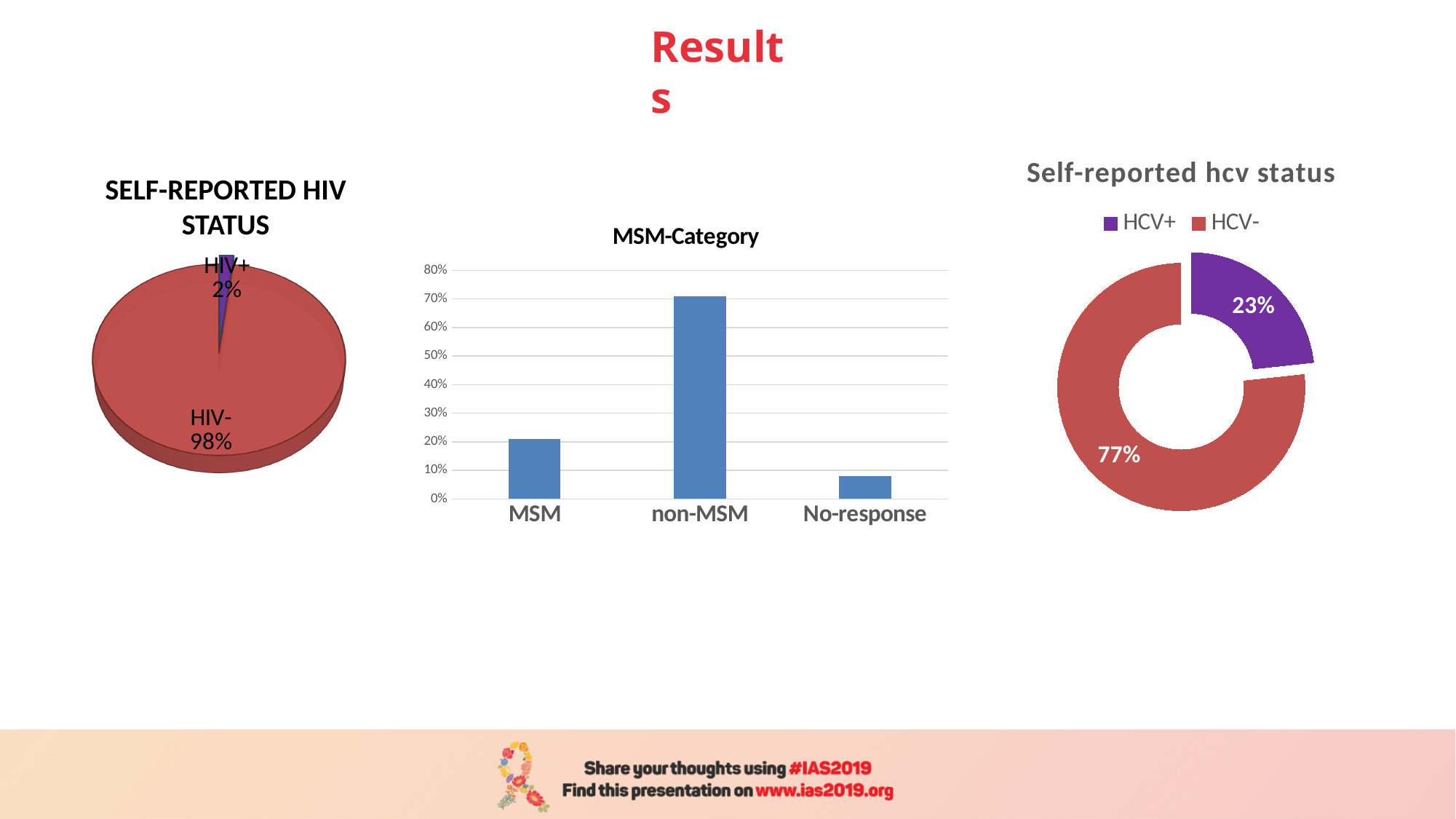
In the Self-reported hcv status chart, what percentage is HCV+? 23% In the SELF-REPORTED HIV STATUS chart, what is the difference between the HIV- and HIV+ shares? 96% What kind of chart is the MSM-Category chart? Bar chart How many series does the legend of the Self-reported hcv status chart list? 2 In the MSM-Category chart, is the value for non-MSM greater or less than 60%? greater What kind of chart is the SELF-REPORTED HIV STATUS chart? Pie chart How many categories are shown in the MSM-Category chart? 3 In the MSM-Category chart, which category has the lowest value? No-response In the SELF-REPORTED HIV STATUS chart, what percentage is HIV+? 2% In the MSM-Category chart, which category has the highest value? non-MSM In the MSM-Category chart, is the value for MSM greater or less than 30%? less In the SELF-REPORTED HIV STATUS chart, what percentage is HIV-? 98%